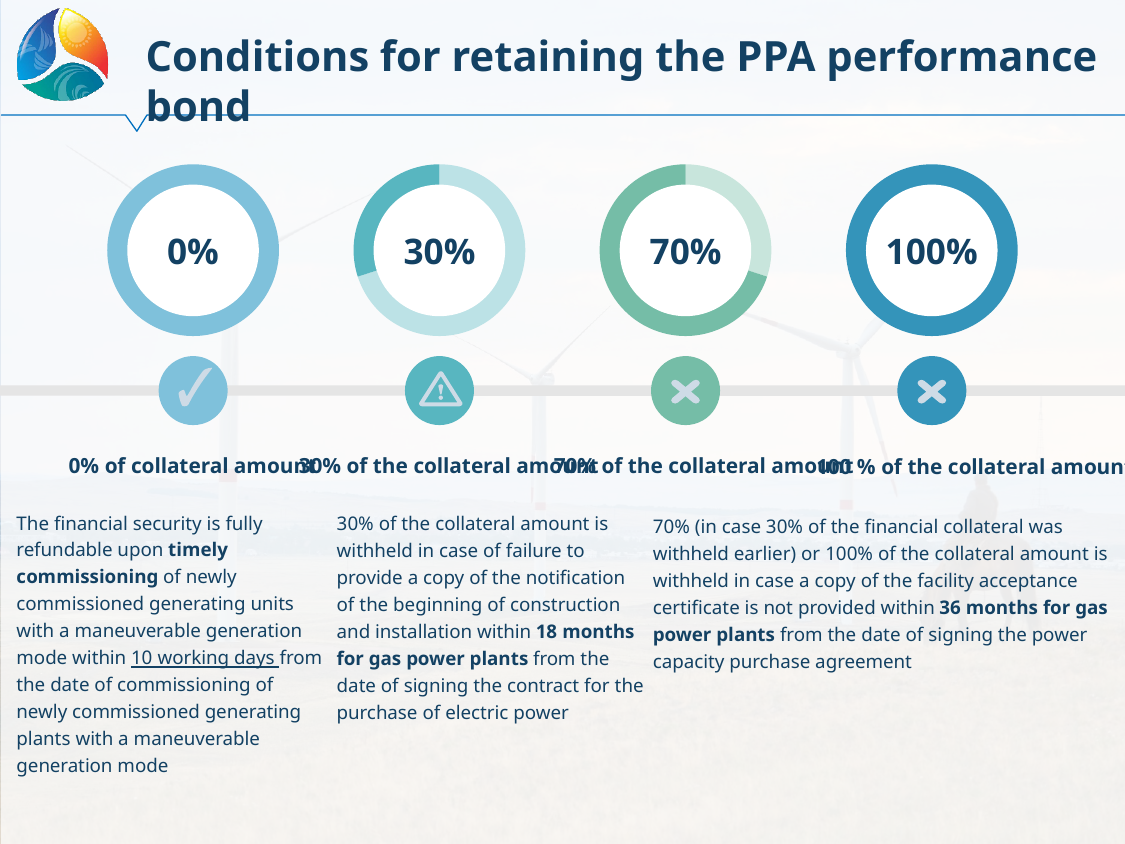
What icon appears below the 0% ring chart? A check mark Which ring chart shows the highest percentage? The rightmost one, 100% What value is shown in the centre of the leftmost ring chart? 0% What kind of chart is used to display the percentages on the slide? Doughnut chart Do the ring chart values rise or fall from left to right across the slide? Rise How many ring charts are shown on the slide? 4 What value is shown in the centre of the third ring chart from the left? 70% What value is shown in the centre of the rightmost ring chart? 100% Which ring chart shows the lowest percentage? The leftmost one, 0% Which is larger, the value in the second ring chart or the value in the third ring chart? The third ring chart (70%) What value is shown in the centre of the second ring chart from the left? 30% What is the difference between the value in the third ring chart and the value in the second ring chart? 40 percentage points